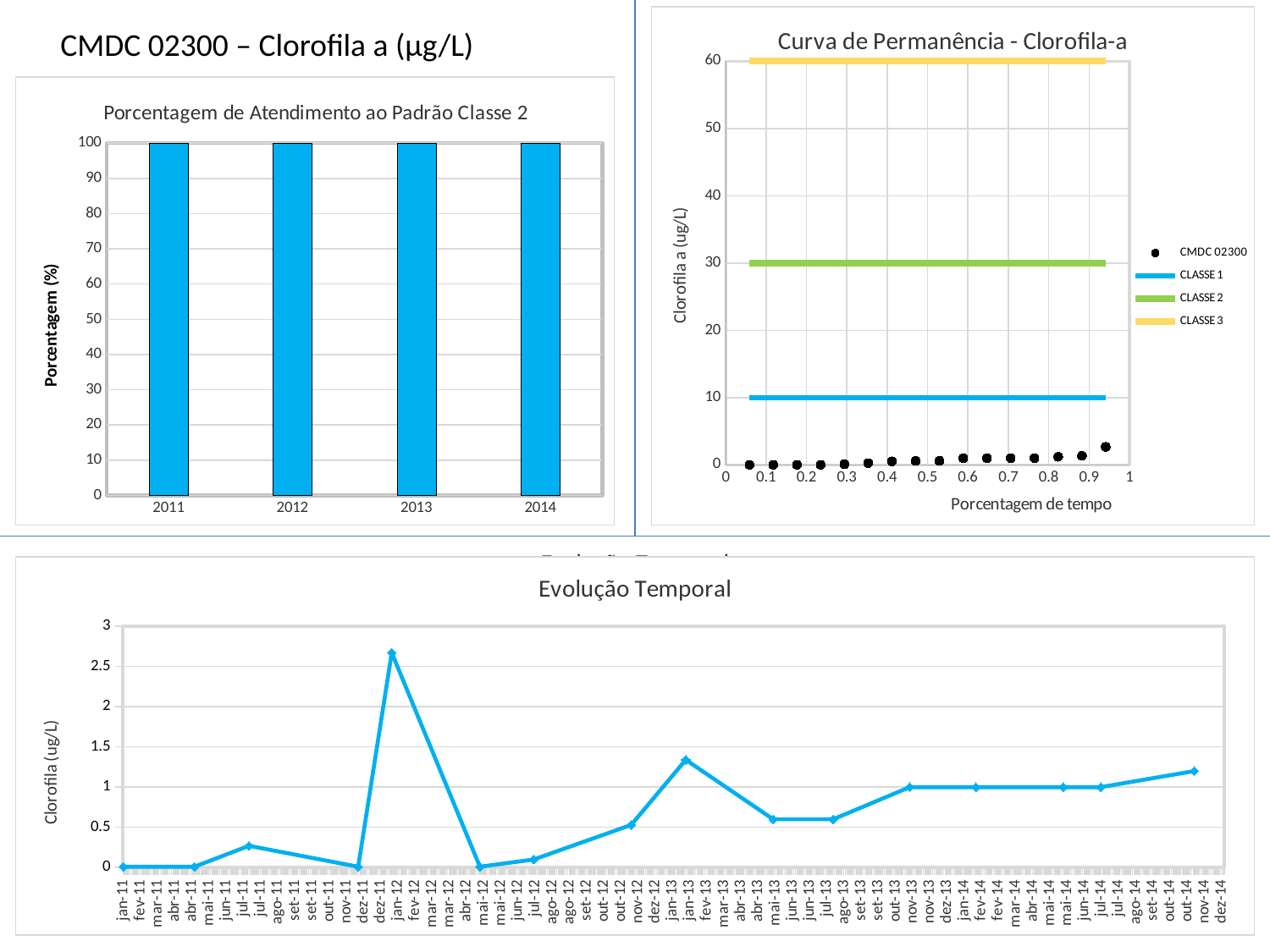
In the chart titled "Porcentagem de Atendimento ao Padrão Classe 2", what is the label of the y axis? Porcentagem (%) In the chart titled "Porcentagem de Atendimento ao Padrão Classe 2", what is the value for 2014? 100 In the chart titled "Evolução Temporal", is the value for jan-12 greater or less than 2? greater In the chart titled "Curva de Permanência - Clorofila-a", at what Clorofila a value is the CLASSE 3 line drawn? 60 In the chart titled "Porcentagem de Atendimento ao Padrão Classe 2", what is the value for 2011? 100 What kind of chart is "Porcentagem de Atendimento ao Padrão Classe 2"? Bar chart In the chart titled "Curva de Permanência - Clorofila-a", at what Clorofila a value is the CLASSE 1 line drawn? 10 In the chart titled "Curva de Permanência - Clorofila-a", how many series does the legend list? 4 In the chart titled "Evolução Temporal", which month has the highest value? jan-12 In the chart titled "Curva de Permanência - Clorofila-a", which class line is the highest? CLASSE 3 In the chart titled "Curva de Permanência - Clorofila-a", are the CMDC 02300 points greater or less than 10? less In the chart titled "Porcentagem de Atendimento ao Padrão Classe 2", how many years are shown on the x axis? 4